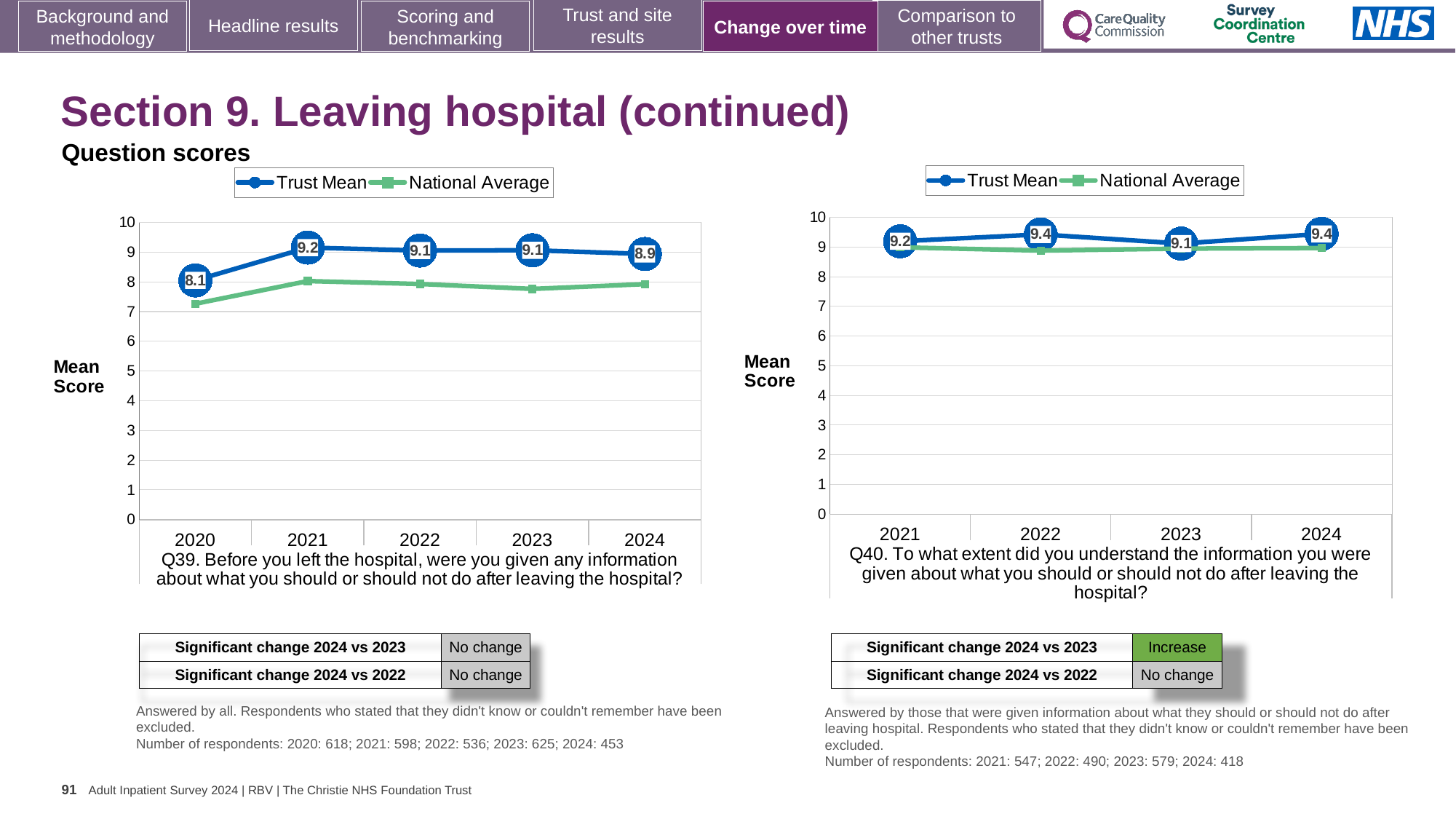
On the Q39 chart (left), is the National Average for 2020 greater or less than 8? less On the Q39 chart (left), what is the Trust Mean score for 2020? 8.1 On the Q40 chart (right), what is the Trust Mean score for 2023? 9.1 On the Q39 chart (left), which year has the highest Trust Mean score? 2021 On the Q39 chart (left), what is the Trust Mean score for 2024? 8.9 What type of chart is used for the Q39 chart (left)? Line chart How many series does the legend of the Q40 chart (right) list? 2 On the Q39 chart (left), how many years are shown on the x axis? 5 On the Q40 chart (right), which year has the lowest Trust Mean score? 2023 On the Q40 chart (right), is the Trust Mean for 2022 larger or smaller than the Trust Mean for 2023? larger On the Q39 chart (left), what is the difference between the Trust Mean scores for 2021 and 2020? 1.1 On the Q39 chart (left), which year has the lowest Trust Mean score? 2020